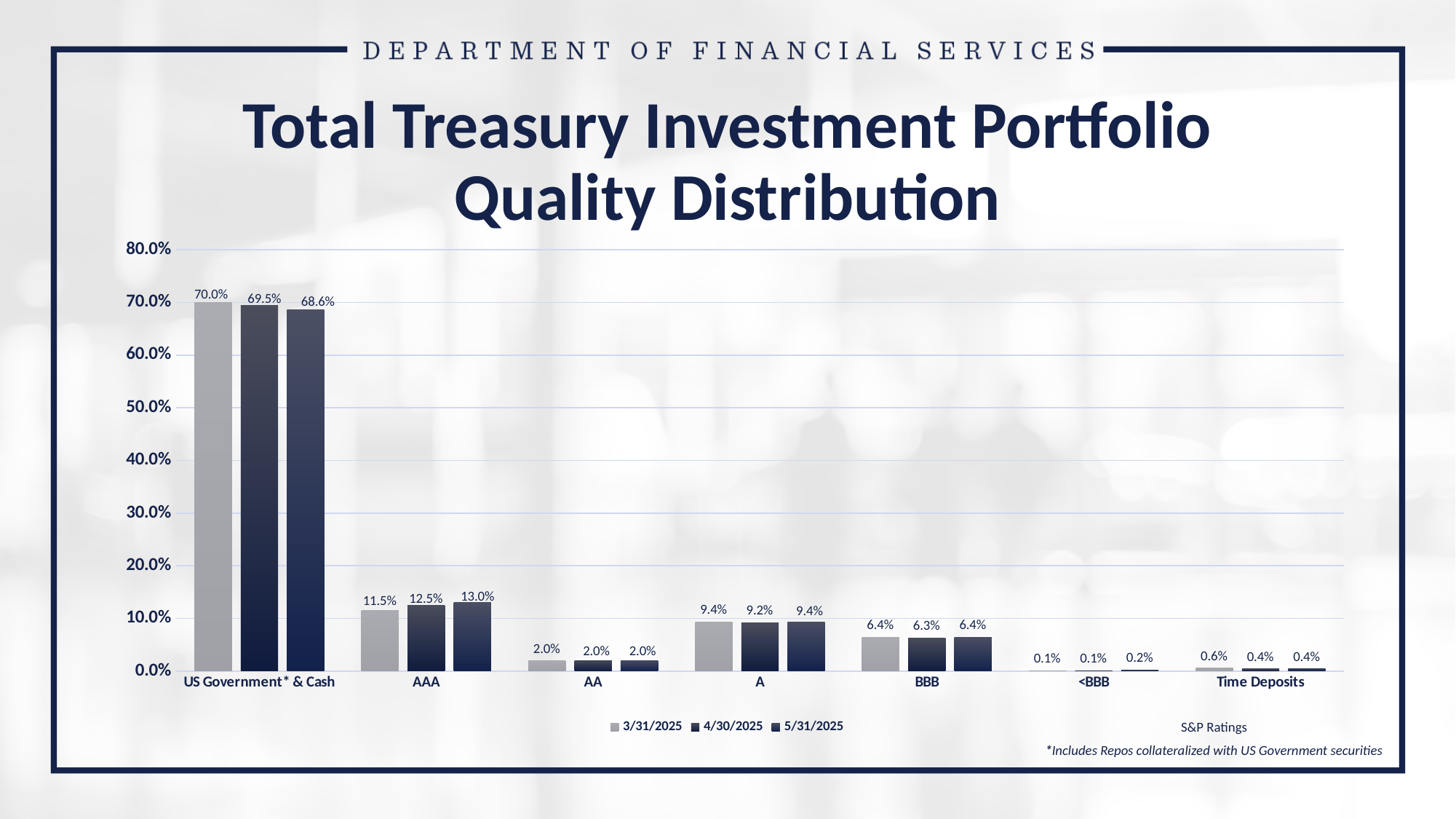
What is the value for US Government* & Cash in the 5/31/2025 series? 68.6% What is the difference between the 3/31/2025 and 5/31/2025 values for US Government* & Cash? 1.4% Which category has the lowest value in the 3/31/2025 series? <BBB What is the value for Time Deposits in the 3/31/2025 series? 0.6% Which is larger for AAA: the 3/31/2025 value or the 5/31/2025 value? 5/31/2025 What kind of chart is shown on the slide? Bar chart How many categories are shown on the x axis? 7 What is the value for AAA in the 3/31/2025 series? 11.5% How many series does the legend list? 3 What is the title of the chart? Total Treasury Investment Portfolio Quality Distribution Which category has the highest value in the 4/30/2025 series? US Government* & Cash What is the value for BBB in the 4/30/2025 series? 6.3%